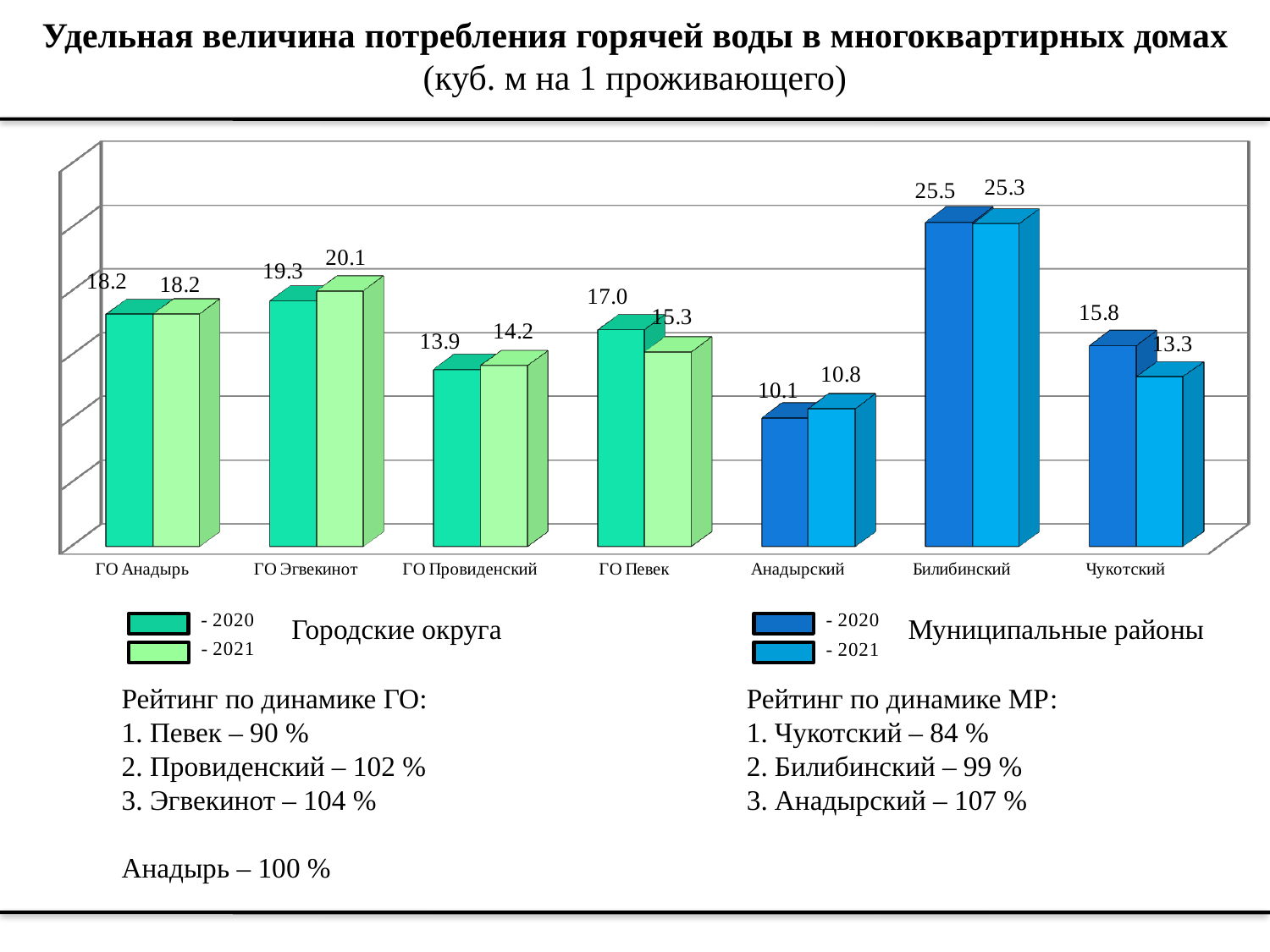
How many years (series) are compared for each category? 2 Which category has the lowest 2021 value? Анадырский How many categories are shown on the x axis? 7 Which is larger for ГО Провиденский: the 2020 value or the 2021 value? 2021 What is the 2021 value for ГО Эгвекинот? 20.1 What kind of chart is shown on the slide? Bar chart Which category has the highest 2020 value? Билибинский What colour are the bars for the municipal districts (Муниципальные районы)? Blue What is the 2021 value for Анадырский? 10.8 What is the difference between the 2020 and 2021 values for Чукотский? 2.5 What is the 2020 value for Чукотский? 15.8 What is the difference between the 2020 and 2021 values for ГО Певек? 1.7